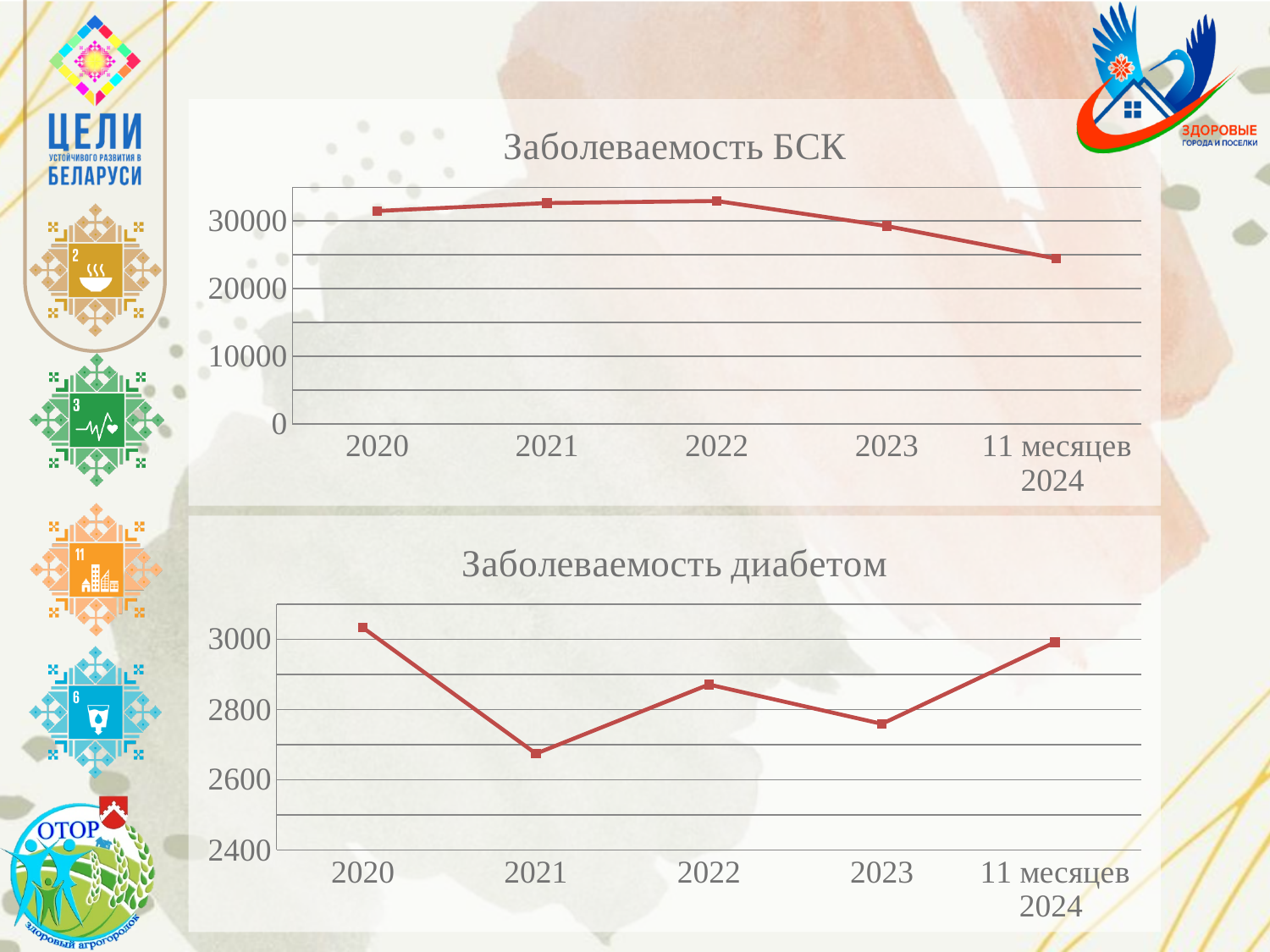
On the "Заболеваемость диабетом" chart, which category has the lowest value? 2021 On the "Заболеваемость диабетом" chart, is the value for 2021 greater or less than 2800? less On the "Заболеваемость диабетом" chart, is the value for 2022 greater or less than 2800? greater On the "Заболеваемость БСК" chart, do the values rise or fall from 2022 to 11 месяцев 2024? fall On the "Заболеваемость диабетом" chart, which is larger: the value for 2021 or the value for 2022? 2022 What is the title of the lower chart on the slide? Заболеваемость диабетом On the "Заболеваемость БСК" chart, is the value for 2020 greater or less than 30000? greater On the "Заболеваемость БСК" chart, which category has the lowest value? 11 месяцев 2024 What kind of chart is the "Заболеваемость БСК" chart? line chart On the "Заболеваемость БСК" chart, which is larger: the value for 2020 or the value for 11 месяцев 2024? 2020 How many points are plotted on the "Заболеваемость диабетом" chart? 5